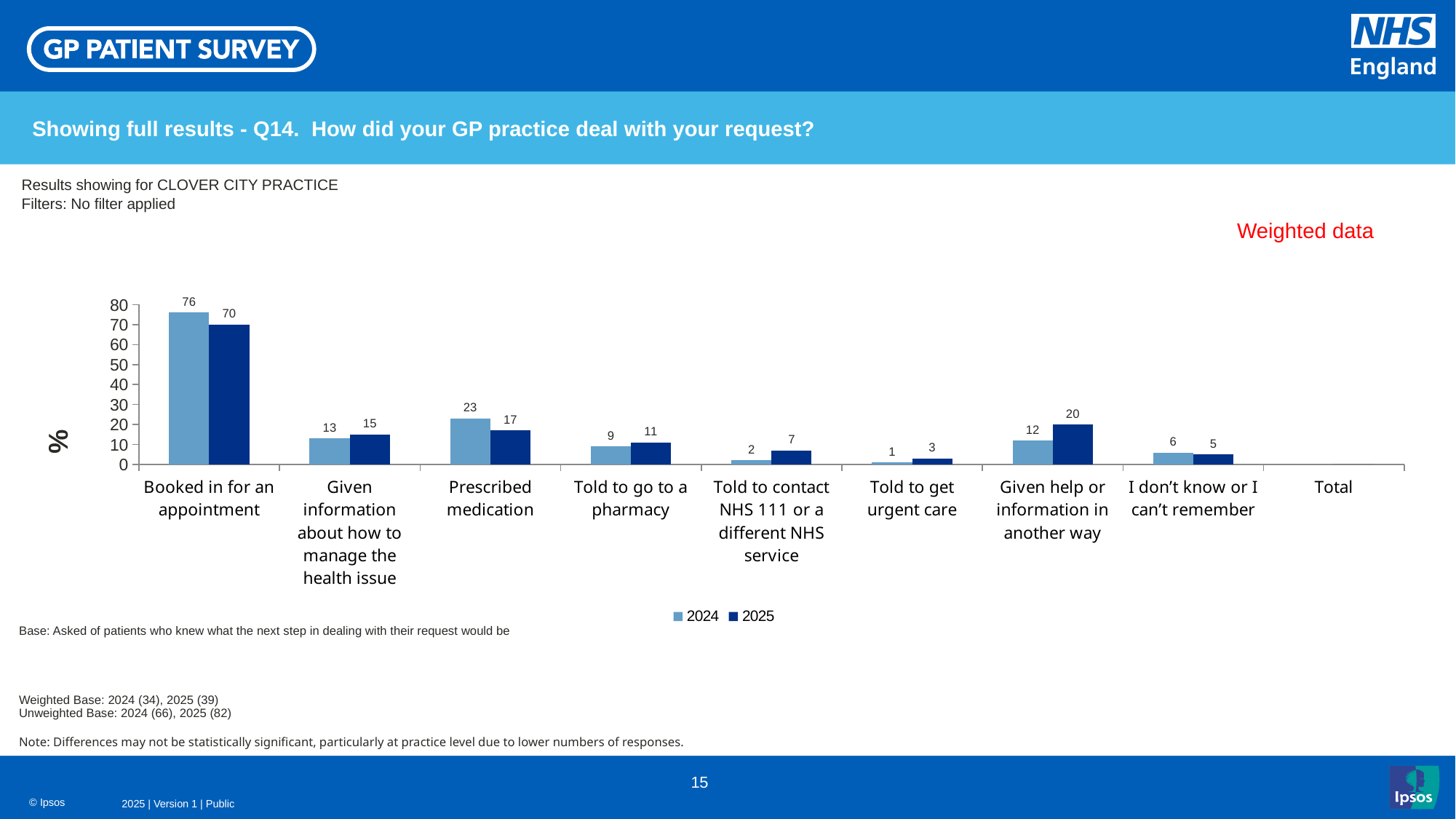
What is the difference between the 2024 and 2025 values for 'Booked in for an appointment'? 6 What is the 2024 value for 'Told to contact NHS 111 or a different NHS service'? 2 Which is larger for 'Told to go to a pharmacy', the 2024 value or the 2025 value? 2025 Which category has the lowest 2024 value? Told to get urgent care What kind of chart is shown on the slide? Bar chart What label is shown on the vertical axis of the chart? % How many series does the legend list? 2 Is the 2024 value for 'Prescribed medication' greater or less than 20? greater What is the 2025 value for 'Given help or information in another way'? 20 What is the 2024 value for 'Booked in for an appointment'? 76 What is the 2025 value for 'Prescribed medication'? 17 Which category has the highest 2025 value? Booked in for an appointment